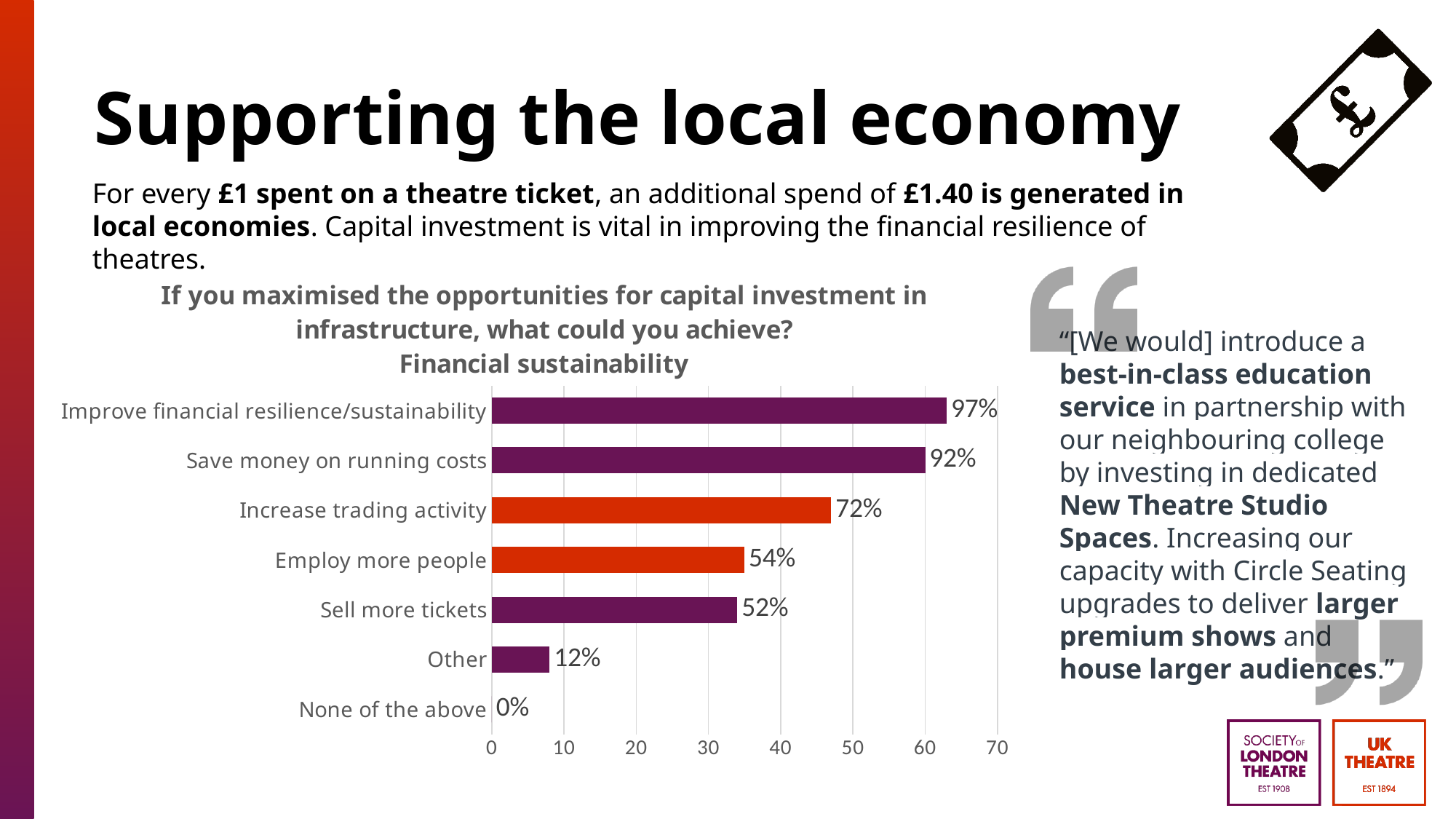
What percentage is shown for 'Employ more people'? 54% What is the difference in percentage points between 'Improve financial resilience/sustainability' and 'Sell more tickets'? 45 Which category has the lowest value in the chart? None of the above What is the last line of the chart's title? Financial sustainability What percentage is shown for 'None of the above'? 0% What percentage is shown for 'Other'? 12% What percentage is shown for 'Improve financial resilience/sustainability'? 97% Which is larger: the value for 'Increase trading activity' or the value for 'Employ more people'? Increase trading activity How many categories are shown in the chart? 7 Which category has the highest value in the chart? Improve financial resilience/sustainability What type of chart is shown on the slide? Bar chart What is the difference in percentage points between 'Save money on running costs' and 'Increase trading activity'? 20